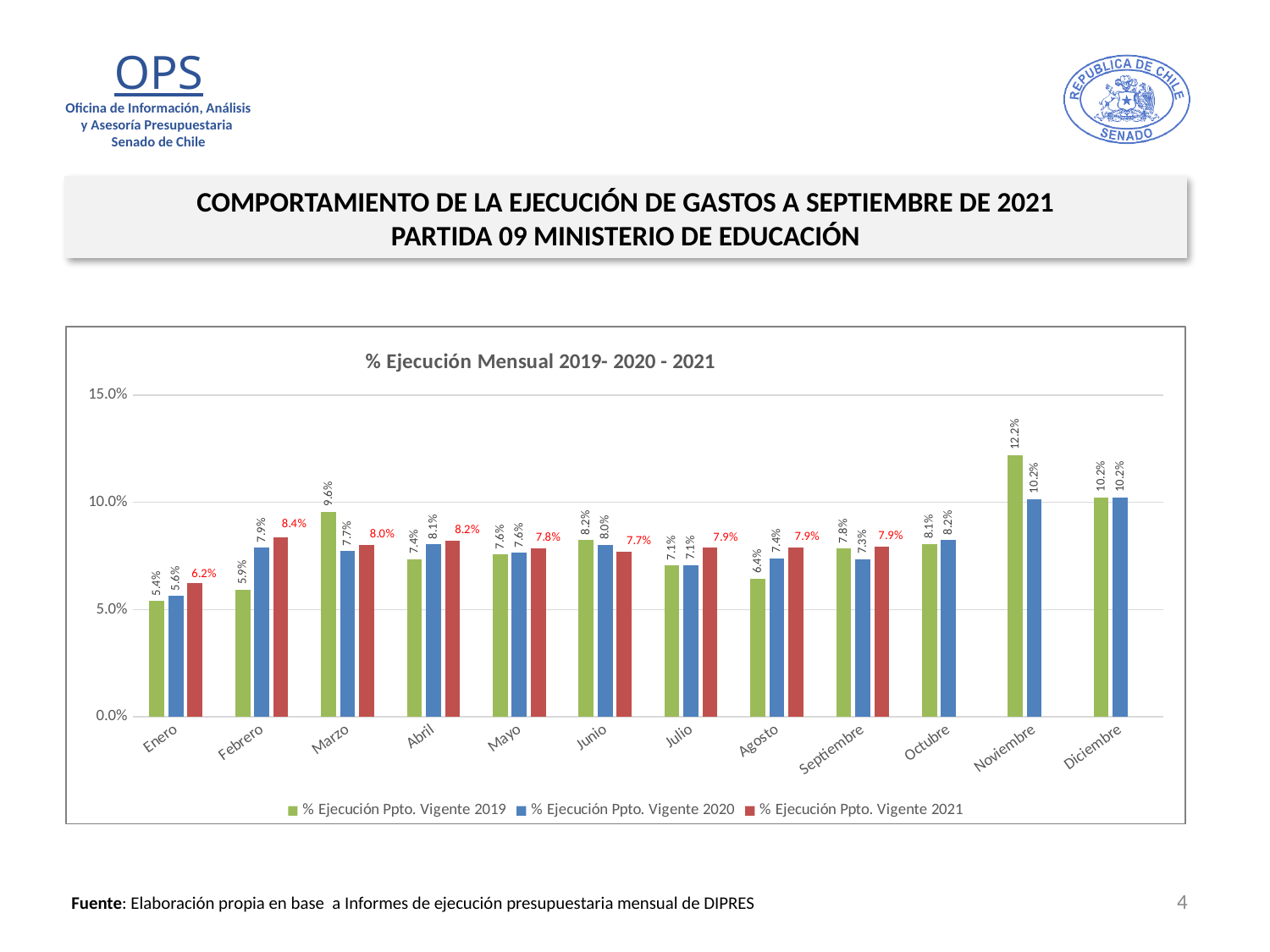
How many series does the legend list? 3 What is the % Ejecución Ppto. Vigente 2020 value for Agosto? 7.4% How many months are shown on the x axis? 12 Which month has the highest % Ejecución Ppto. Vigente 2019 value? Noviembre What is the % Ejecución Ppto. Vigente 2021 value for Febrero? 8.4% Which month has the lowest % Ejecución Ppto. Vigente 2021 value? Enero What is the % Ejecución Ppto. Vigente 2019 value for Marzo? 9.6% Is the % Ejecución Ppto. Vigente 2019 value for Noviembre greater or less than 10.0%? greater What is the title of the chart? % Ejecución Mensual 2019- 2020 - 2021 Which is larger for Marzo: the 2019 value or the 2020 value? 2019 value What is the difference between the 2019 and 2020 values for Noviembre? 2.0% What type of chart is shown on the slide? bar chart